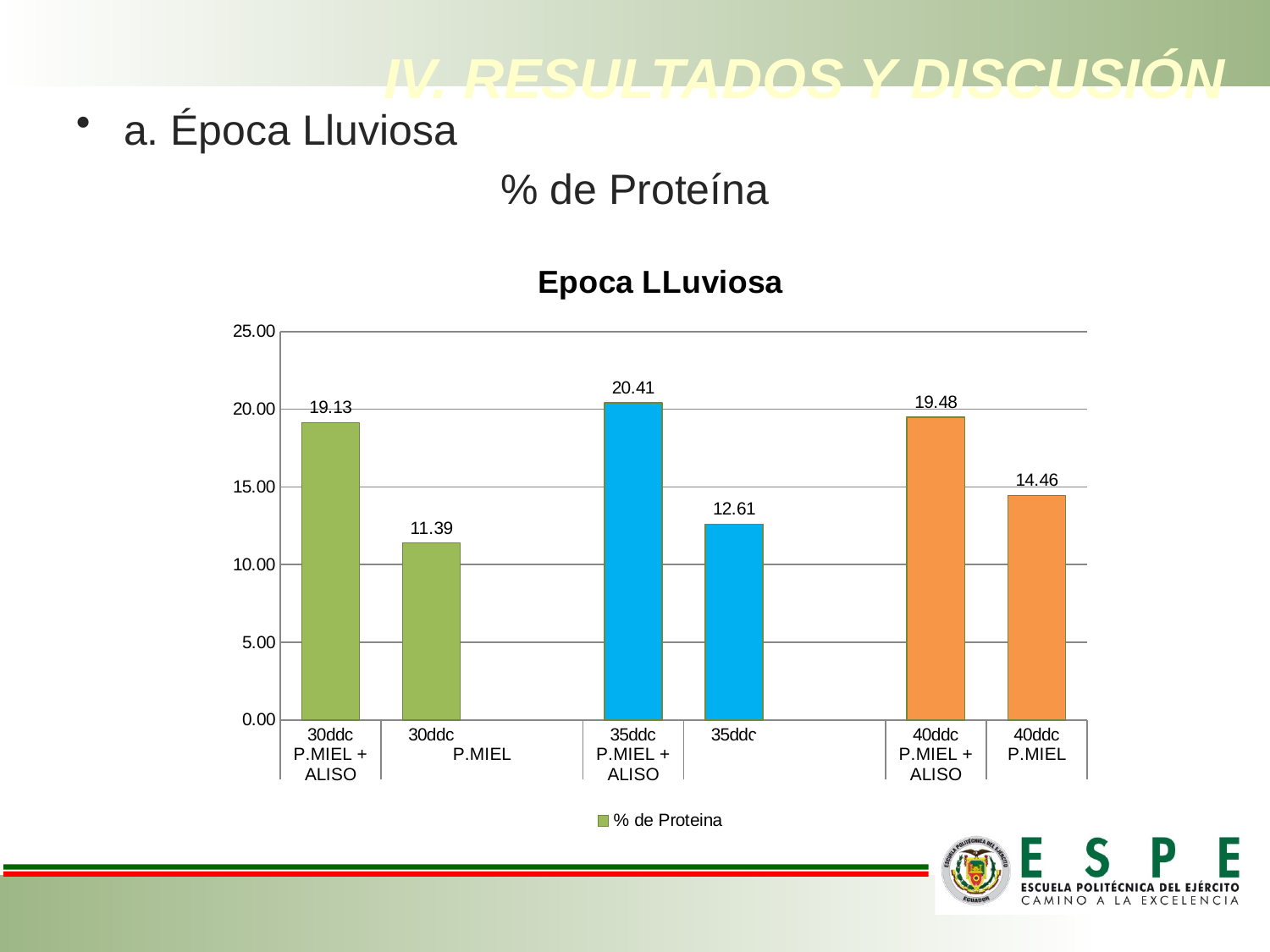
How many series does the legend list? 1 Is the value for the 35ddc bar (the one without ALISO) greater or less than 15.00? less How many bars are plotted in the chart? 6 What is the % de Proteina value for 30ddc P.MIEL? 11.39 Which category has the highest % de Proteina value? 35ddc P.MIEL + ALISO What is the difference between the values for 40ddc P.MIEL + ALISO and 40ddc P.MIEL? 5.02 What type of chart is shown on the slide? bar chart What is the % de Proteina value for 40ddc P.MIEL? 14.46 Which is larger, the value for 30ddc P.MIEL + ALISO or the value for 40ddc P.MIEL + ALISO? 40ddc P.MIEL + ALISO Which category has the lowest % de Proteina value? 30ddc P.MIEL What is the % de Proteina value for 35ddc P.MIEL + ALISO? 20.41 What is the % de Proteina value for 30ddc P.MIEL + ALISO? 19.13